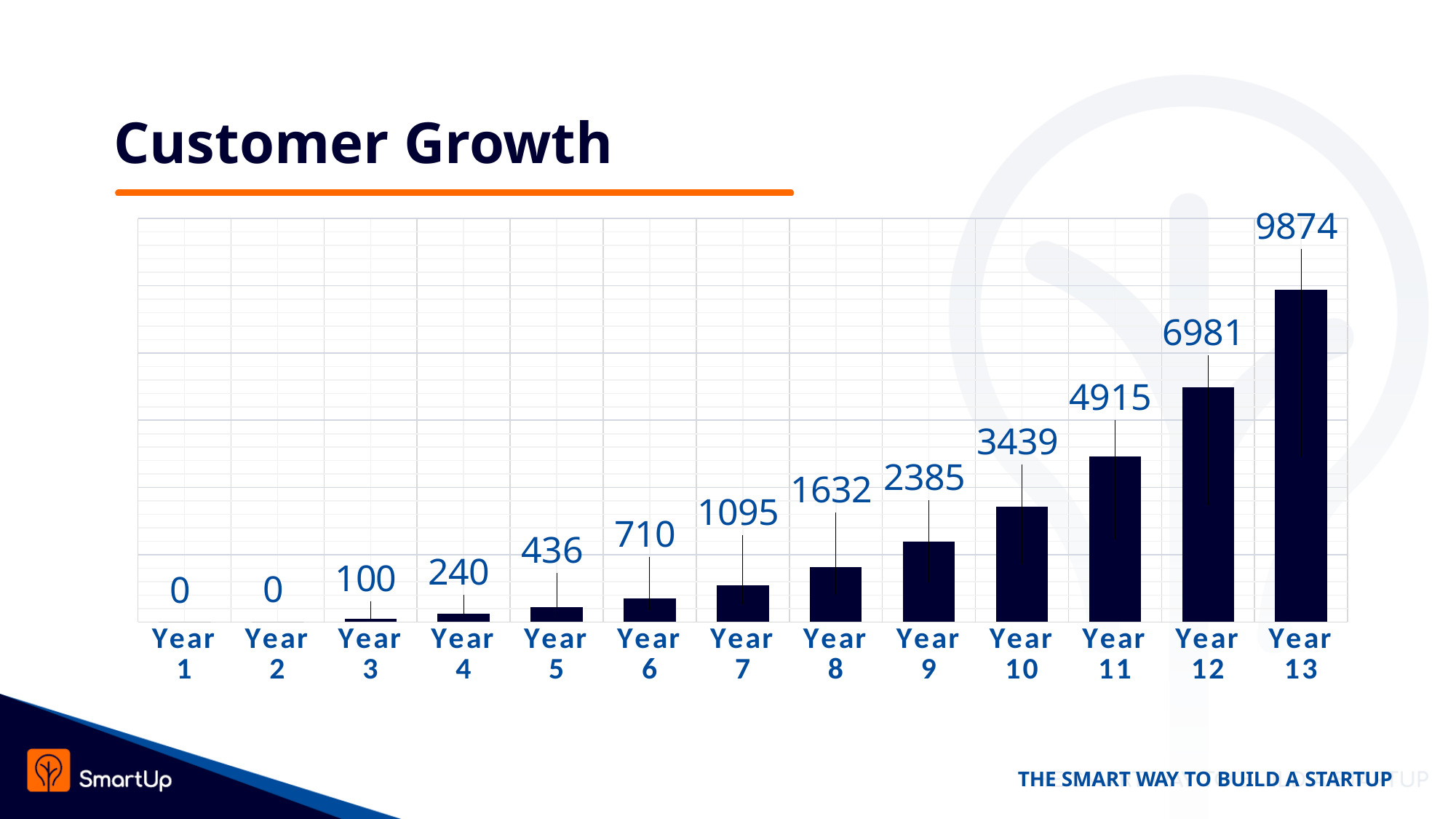
What is the value for Year 3? 100 Do the values rise or fall from Year 3 to Year 13? Rise What is the value for Year 13? 9874 What kind of chart is shown on the slide? Bar chart How many years have a value of 0? 2 Which year has the highest value? Year 13 What is the difference between the values for Year 6 and Year 5? 274 Which is larger, the value for Year 9 or the value for Year 10? Year 10 What is the title of the slide containing the chart? Customer Growth What is the value for Year 7? 1095 What is the difference between the values for Year 12 and Year 11? 2066 How many years are shown on the x axis? 13